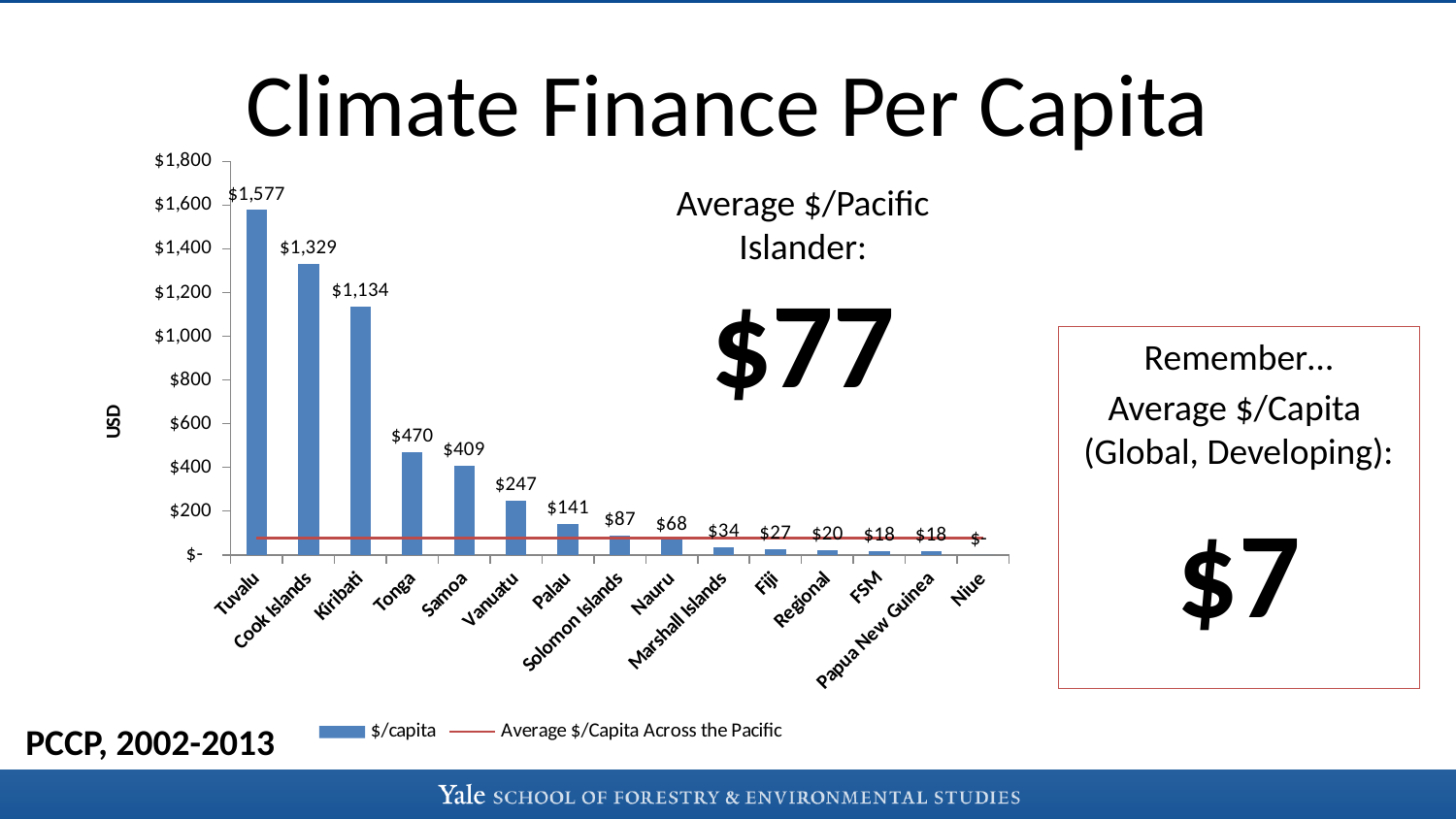
What is the difference between the values for Tonga and Samoa? $61 Which category has the lowest value in the chart? Niue Which category has the highest value in the chart? Tuvalu Which is larger, the value for Palau or the value for Solomon Islands? Palau How many categories are shown on the x axis of the chart? 15 What is the value shown for Kiribati? $1,134 What is the value shown for Vanuatu? $247 What is the climate finance per capita value for Tuvalu? $1,577 Do the bar values rise or fall moving from left to right along the x axis? Fall What kind of chart is used to show the per-capita values? Bar chart How many series does the legend list? 2 What is the difference between the values for Tuvalu and Cook Islands? $248